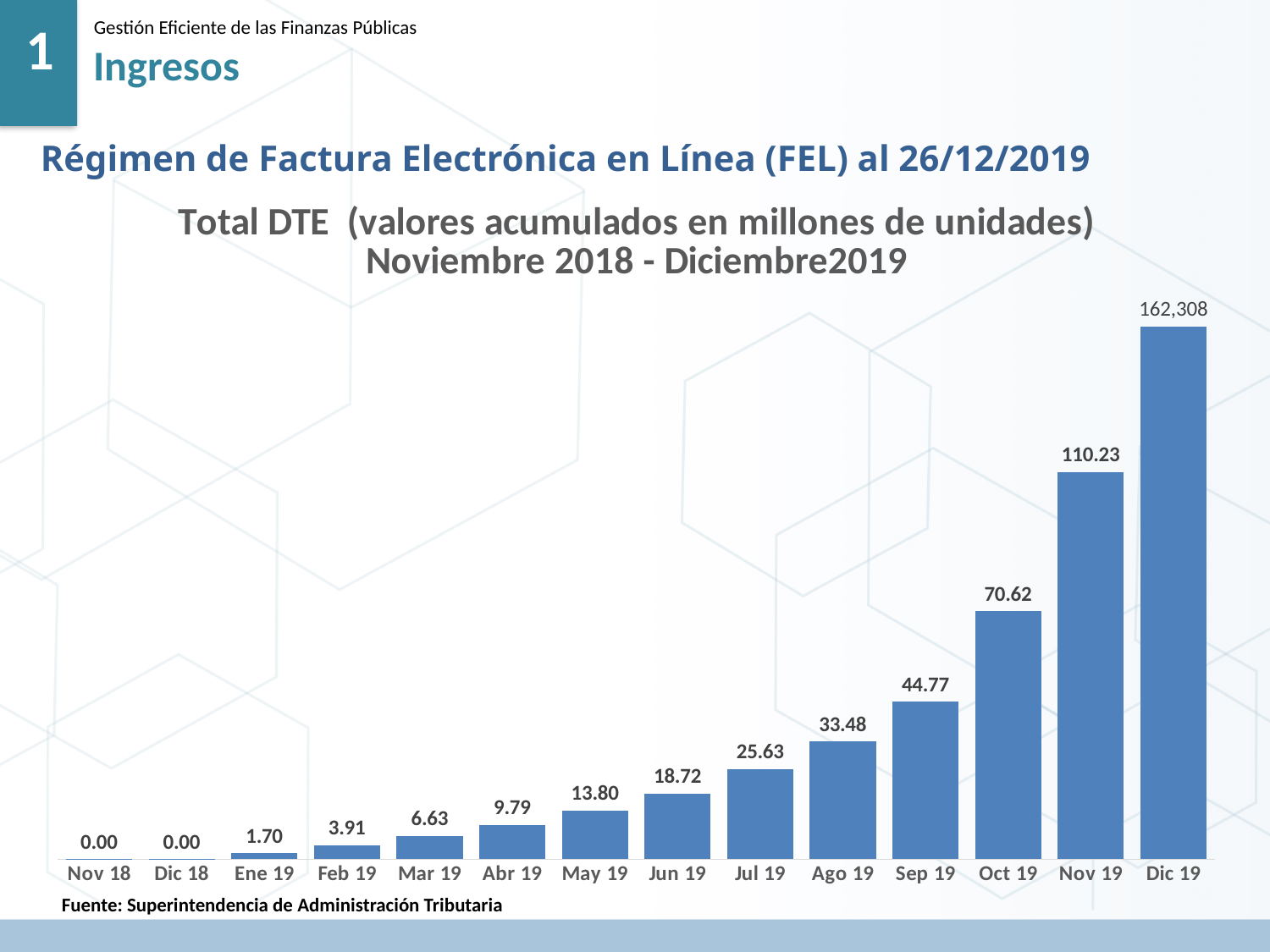
Which is larger, the value for Jul 19 or the value for May 19? Jul 19 How many months are shown on the x axis? 14 Do the values rise or fall from Nov 18 to Dic 19? Rise What is the difference between the values for Nov 19 and Oct 19? 39.61 What is the value for Ene 19? 1.70 What kind of chart is this? Bar chart What is the value for Oct 19? 70.62 What is the value for Jun 19? 18.72 What is the value shown for Dic 19? 162,308 Which month has the highest value? Dic 19 What is the source cited below the chart? Superintendencia de Administración Tributaria What is the difference between the values for Sep 19 and Ago 19? 11.29